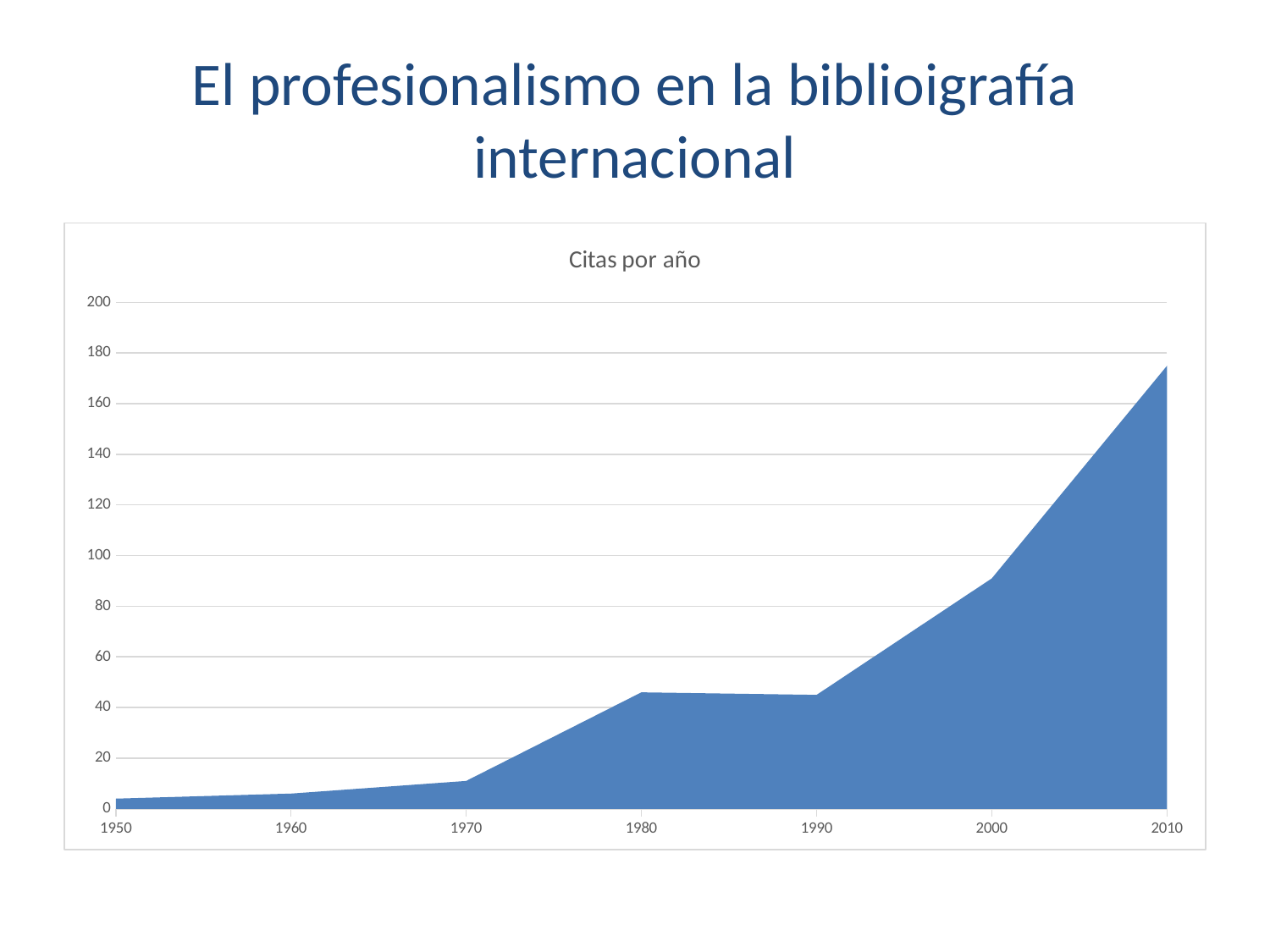
How many years are plotted along the x axis? 7 Which is larger, the value for 2000 or the value for 2010? 2010 What kind of chart is shown on the slide? Area chart Do the values generally rise or fall from 1950 to 2010? Rise Is the value for 2000 greater or less than 100? less What is the title of the chart? Citas por año Is the value for 2000 greater or less than 80? greater Is the value for 1970 greater or less than 20? less Which year has the highest value? 2010 Which year has the lowest value? 1950